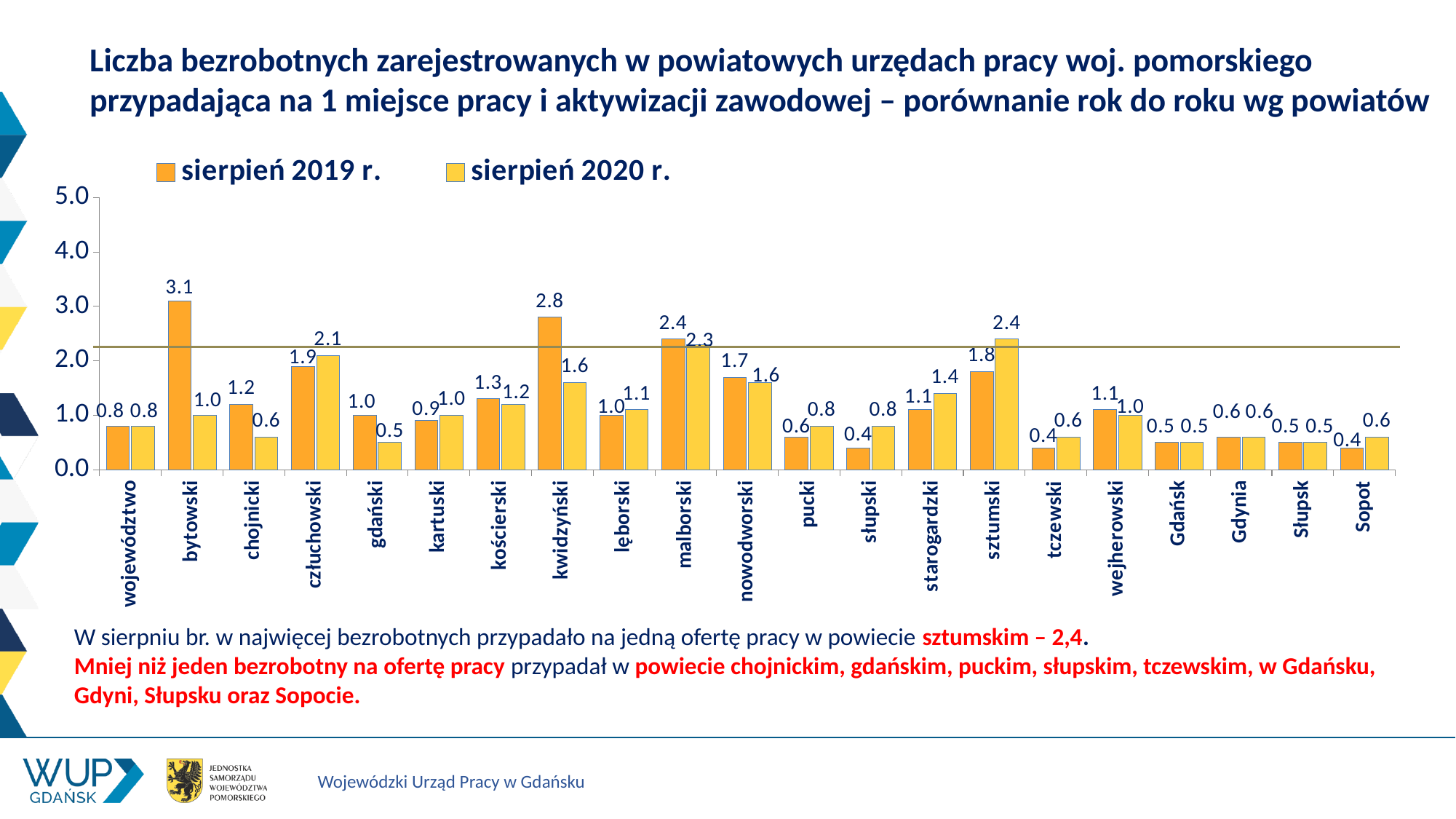
How many categories (powiaty and cities, including województwo) are shown on the x axis? 21 What is the value for sztumski in sierpień 2020 r.? 2.4 What type of chart is shown on the slide? bar chart What is the value for bytowski in sierpień 2019 r.? 3.1 Which is larger for człuchowski: the sierpień 2019 r. value or the sierpień 2020 r. value? sierpień 2020 r. What is the value for kwidzyński in sierpień 2020 r.? 1.6 What is the difference between the sierpień 2019 r. and sierpień 2020 r. values for bytowski? 2.1 What are the two series named in the legend? sierpień 2019 r. and sierpień 2020 r. What is the value for malborski in sierpień 2019 r.? 2.4 Which category has the highest value in sierpień 2020 r.? sztumski Which category has the highest value in sierpień 2019 r.? bytowski How many series does the legend list? 2